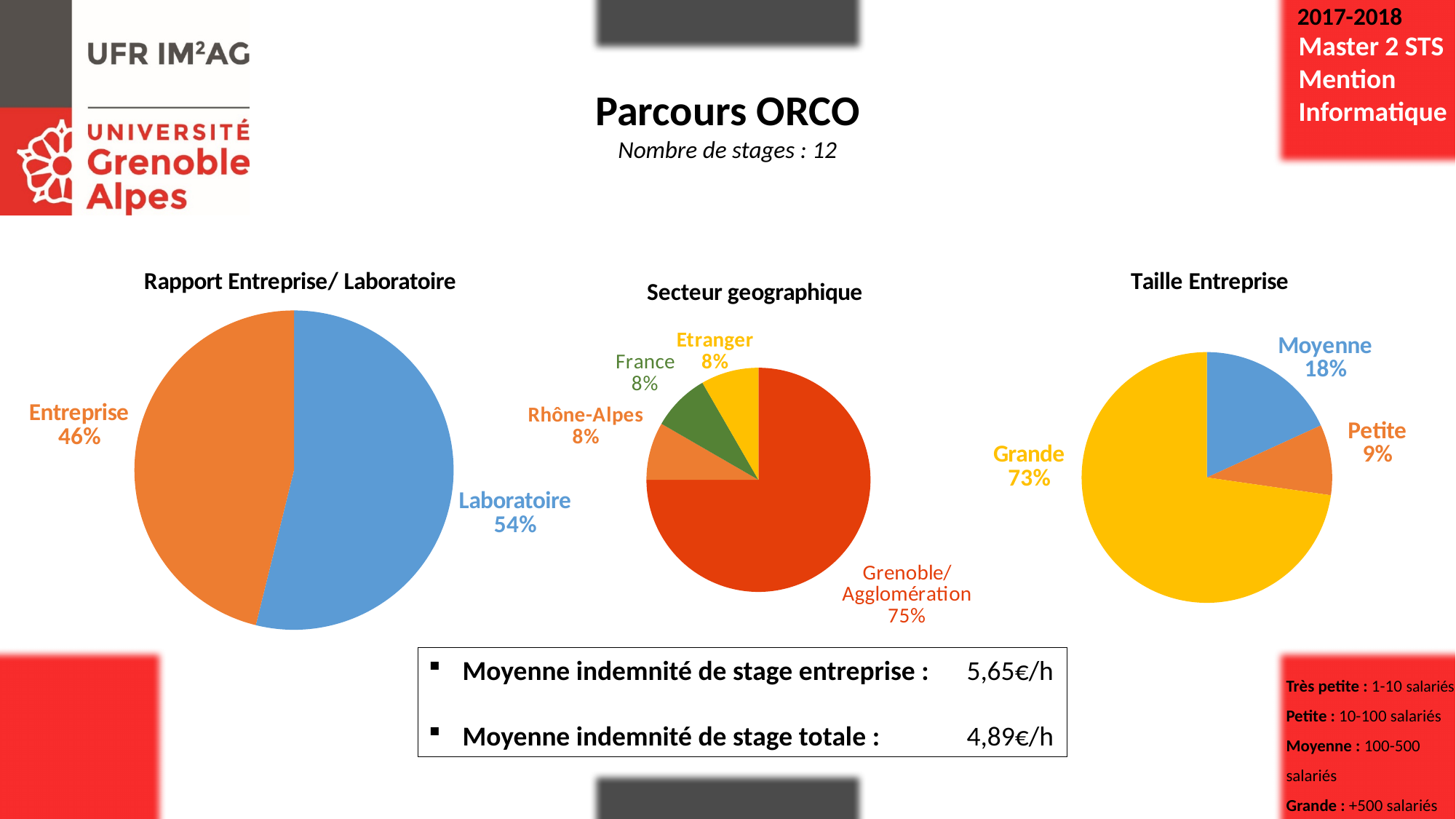
In the 'Rapport Entreprise/ Laboratoire' chart, which slice is larger, Entreprise or Laboratoire? Laboratoire In the 'Taille Entreprise' chart, what is the difference between the Moyenne and Petite shares? 9% How many categories are shown in the 'Taille Entreprise' chart? 3 What kind of chart is the 'Taille Entreprise' chart? Pie chart How many categories are shown in the 'Secteur geographique' chart? 4 In the 'Secteur geographique' chart, which category has the largest share? Grenoble/Agglomération In the 'Rapport Entreprise/ Laboratoire' chart, what share does Laboratoire have? 54% In the 'Rapport Entreprise/ Laboratoire' chart, what share does Entreprise have? 46% In the 'Secteur geographique' chart, what share does Grenoble/Agglomération have? 75% In the 'Taille Entreprise' chart, which category has the smallest share? Petite